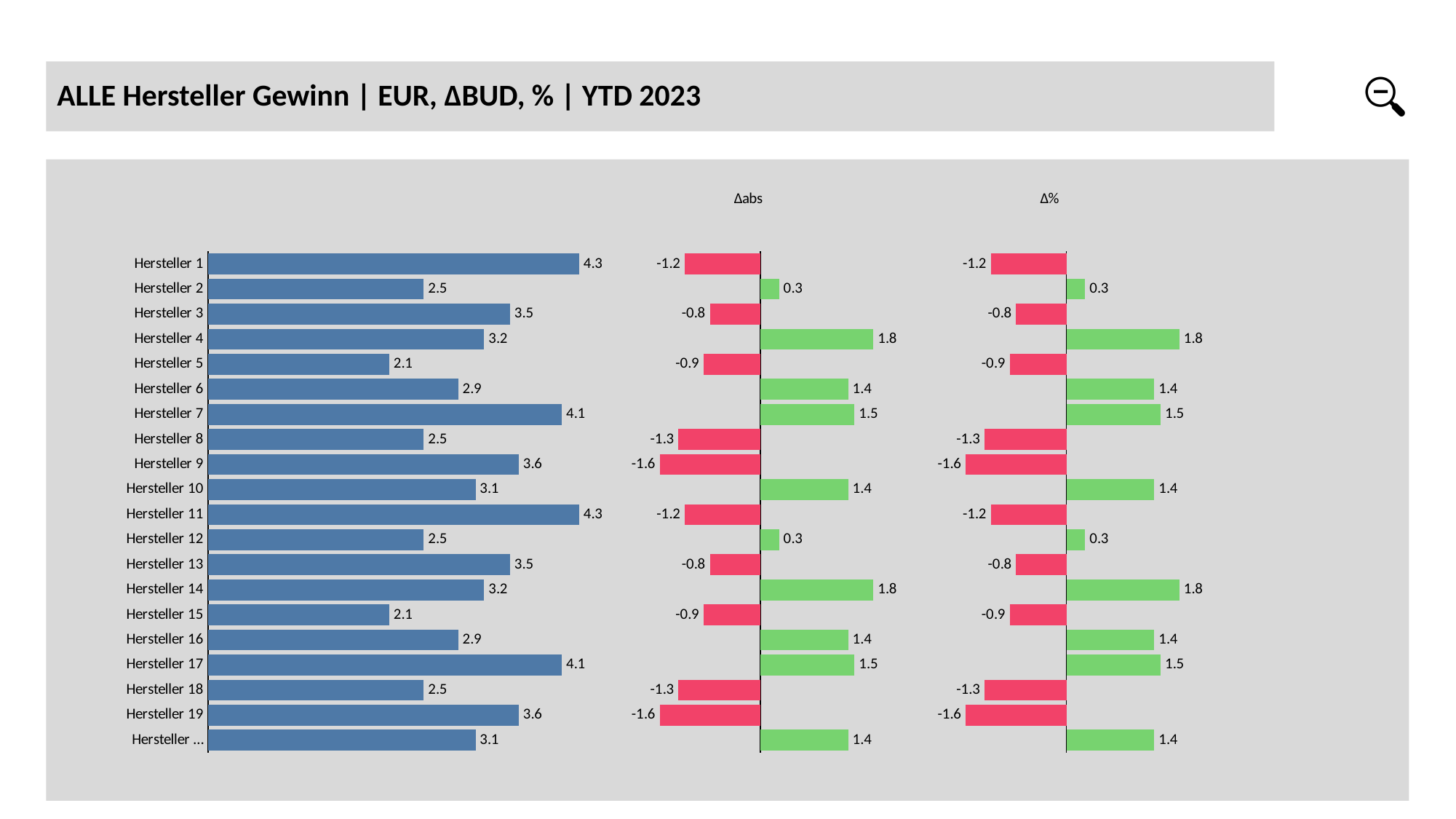
In the Δ% chart, what is the value for Hersteller 4? 1.8 In the left chart (EUR), which is larger, the value for Hersteller 3 or Hersteller 6? Hersteller 3 In the left chart (EUR), what is the value for Hersteller 7? 4.1 In the Δabs chart, what is the difference between the values for Hersteller 4 and Hersteller 2? 1.5 In the Δabs chart, what is the highest value shown? 1.8 What is the title of the slide's chart? ALLE Hersteller Gewinn | EUR, ΔBUD, % | YTD 2023 What kind of chart is the left chart (EUR)? Bar chart In the Δabs chart, what is the value for Hersteller 9? -1.6 In the Δ% chart, what is the lowest value shown? -1.6 In the left chart (EUR), what is the value for Hersteller 15? 2.1 In the left chart (EUR), what is the difference between the values for Hersteller 1 and Hersteller 2? 1.8 How many Hersteller categories are shown in the left chart (EUR)? 20